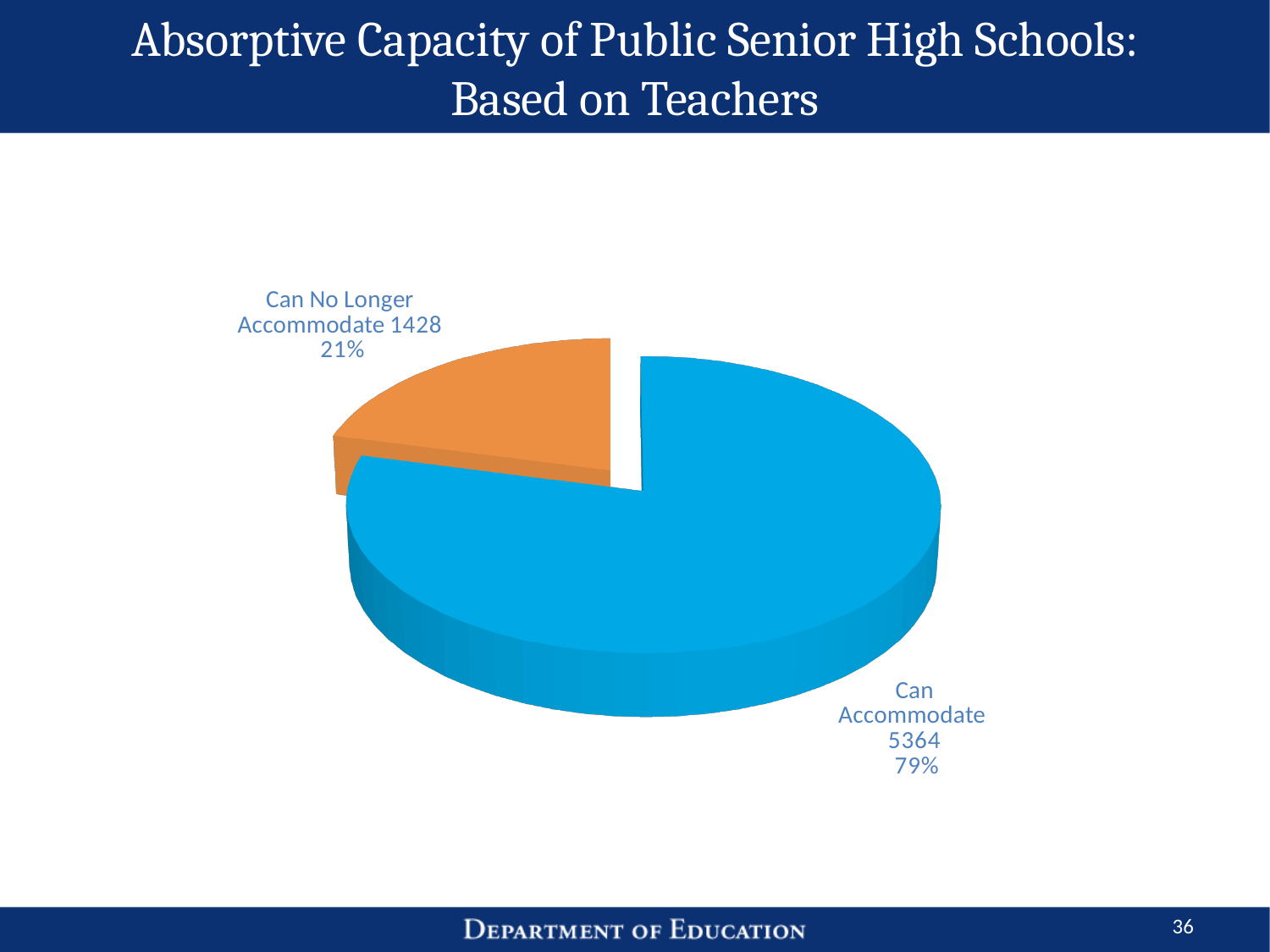
Which category has the smallest slice? Can No Longer Accommodate What is the value for Can Accommodate? 5364 What kind of chart is shown on the slide? Pie chart What is the value for Can No Longer Accommodate? 1428 Which category has the largest slice? Can Accommodate Which is larger, Can Accommodate or Can No Longer Accommodate? Can Accommodate What colour is the Can No Longer Accommodate slice? Orange What is the difference between the values for Can Accommodate and Can No Longer Accommodate? 3936 What share of the pie does Can Accommodate represent? 79% What is the total of the two values shown in the pie chart? 6792 What share of the pie does Can No Longer Accommodate represent? 21% How many slices does the pie chart have? 2